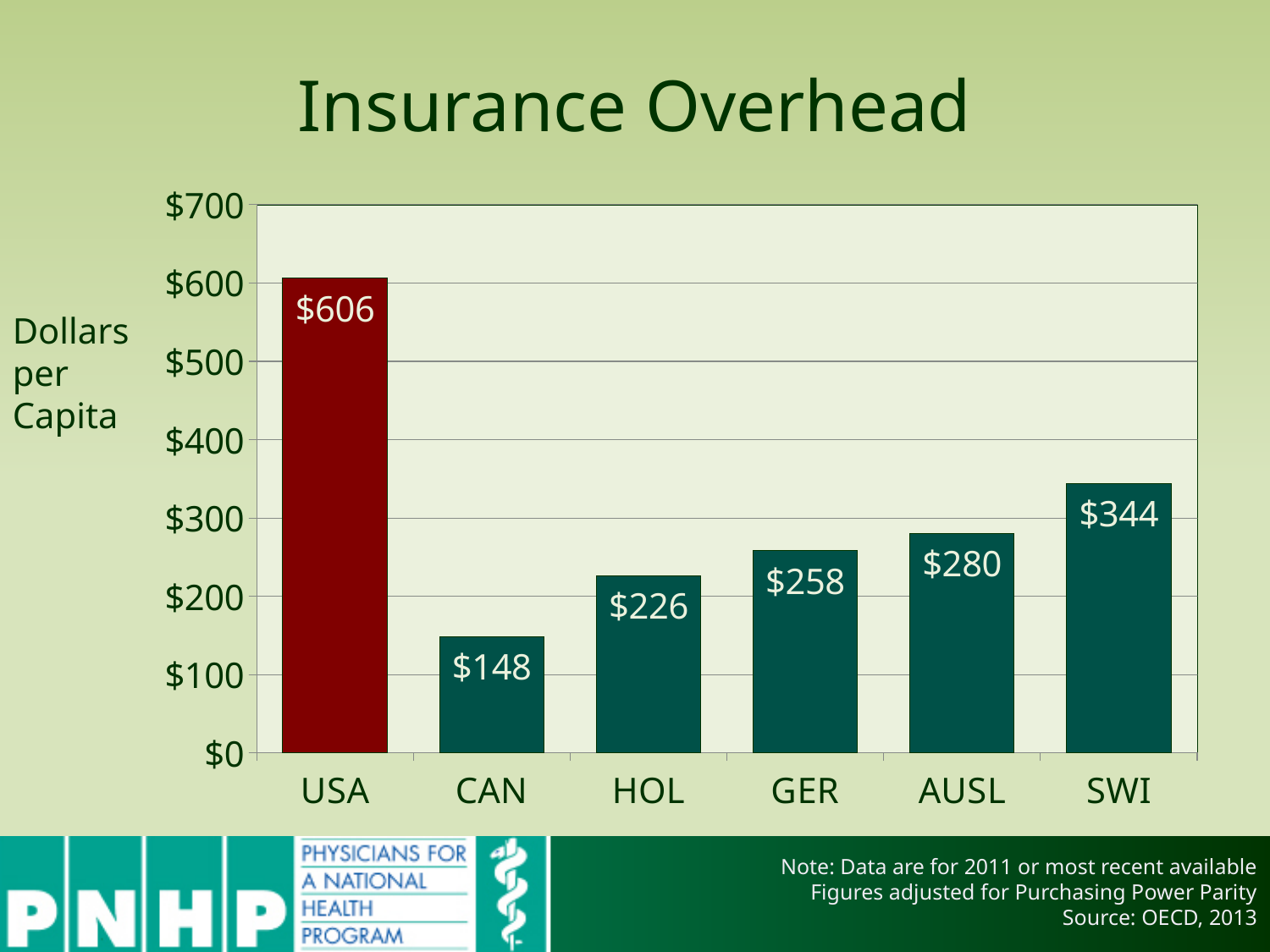
What is the insurance overhead value for SWI? $344 How many countries are shown on the chart? 6 What kind of chart is shown on the slide? bar chart What is the difference between the GER and HOL values? $32 Which is larger, the value for AUSL or the value for GER? AUSL Which country has the highest insurance overhead per capita? USA What is the difference between the USA and SWI values? $262 What is the insurance overhead value for CAN? $148 What is the title of the chart? Insurance Overhead What is the insurance overhead value for USA? $606 Is the value for HOL greater or less than $300? less Which country has the lowest insurance overhead per capita? CAN